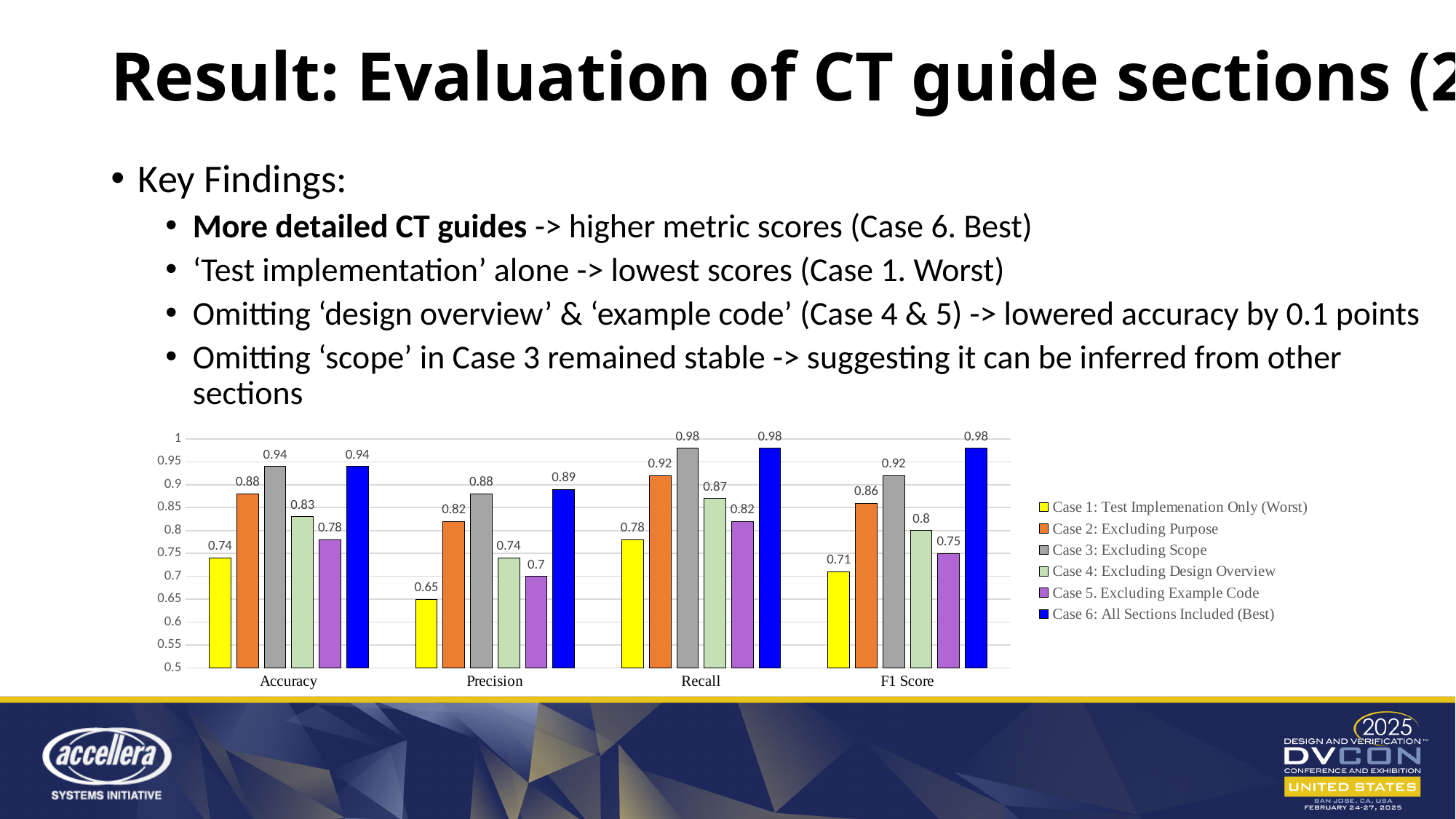
What kind of chart is shown on the slide? Bar chart Which case has the highest Precision? Case 6: All Sections Included (Best) What is the F1 Score value for Case 6: All Sections Included (Best)? 0.98 What is the Precision value for Case 1: Test Implemenation Only (Worst)? 0.65 How many series does the legend list? 6 What colour are the bars for Case 6: All Sections Included (Best)? Blue What is the Recall value for Case 4: Excluding Design Overview? 0.87 Which is larger, the Recall value for Case 2: Excluding Purpose or the Recall value for Case 5. Excluding Example Code? Case 2: Excluding Purpose Which case has the lowest F1 Score? Case 1: Test Implemenation Only (Worst) How many metric categories are shown on the x axis? 4 What is the Accuracy value for Case 5. Excluding Example Code? 0.78 What is the difference between the Accuracy values of Case 3: Excluding Scope and Case 4: Excluding Design Overview? 0.11